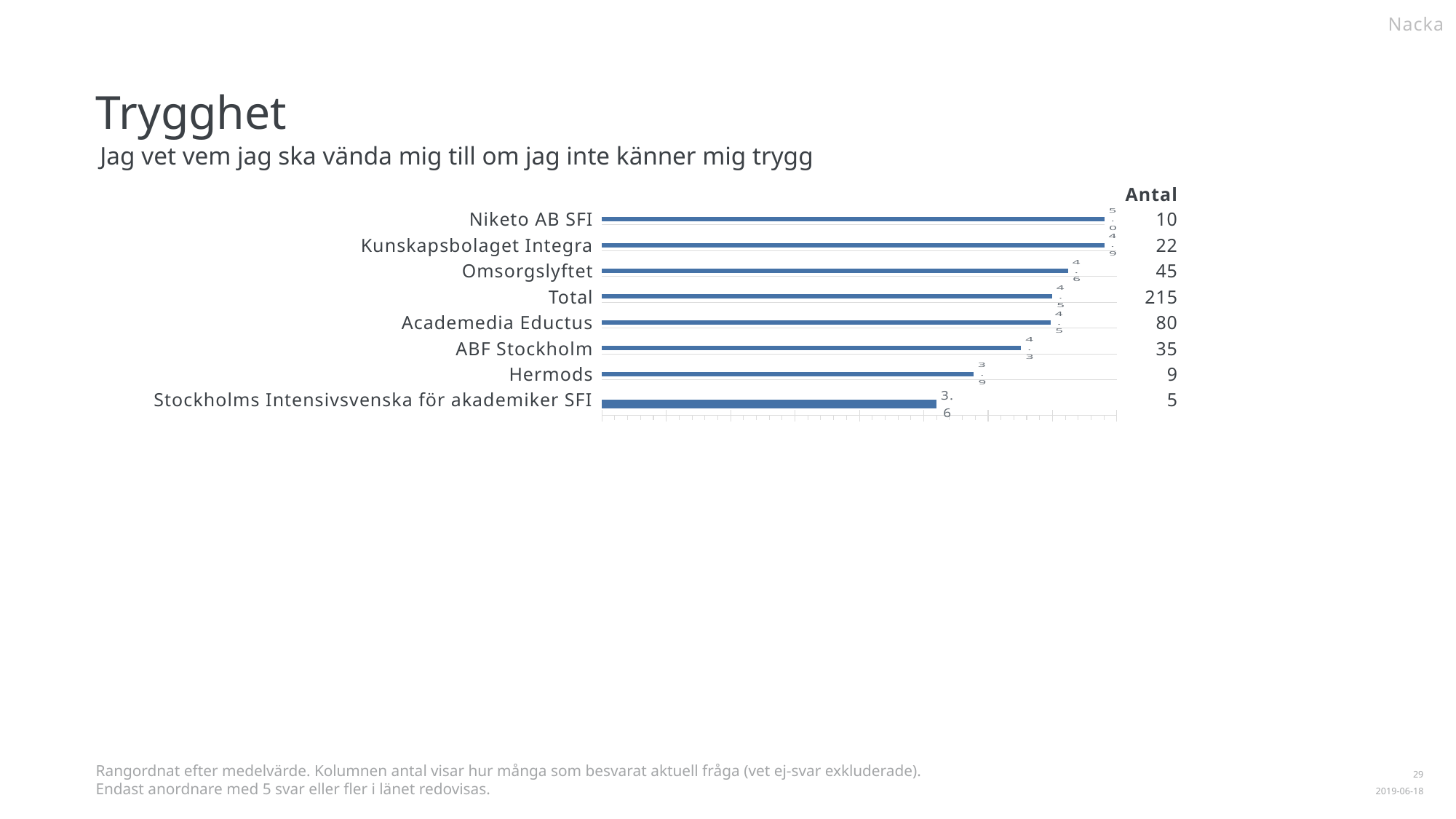
What is the value shown for Niketo AB SFI? 5.0 Which has a larger value, Omsorgslyftet or ABF Stockholm? Omsorgslyftet What is the 'Antal' (number of respondents) shown for Total? 215 What is the value shown for Hermods? 3.9 Which category has the lowest value in the chart? Stockholms Intensivsvenska för akademiker SFI What kind of chart is shown on the slide? bar chart What is the value shown for Total? 4.5 How many bars (categories) does the chart show? 8 What is the difference between the values for Niketo AB SFI and Stockholms Intensivsvenska för akademiker SFI? 1.4 Which category has the highest value in the chart? Niketo AB SFI What is the value shown for Omsorgslyftet? 4.6 What is the 'Antal' (number of respondents) shown for Academedia Eductus? 80